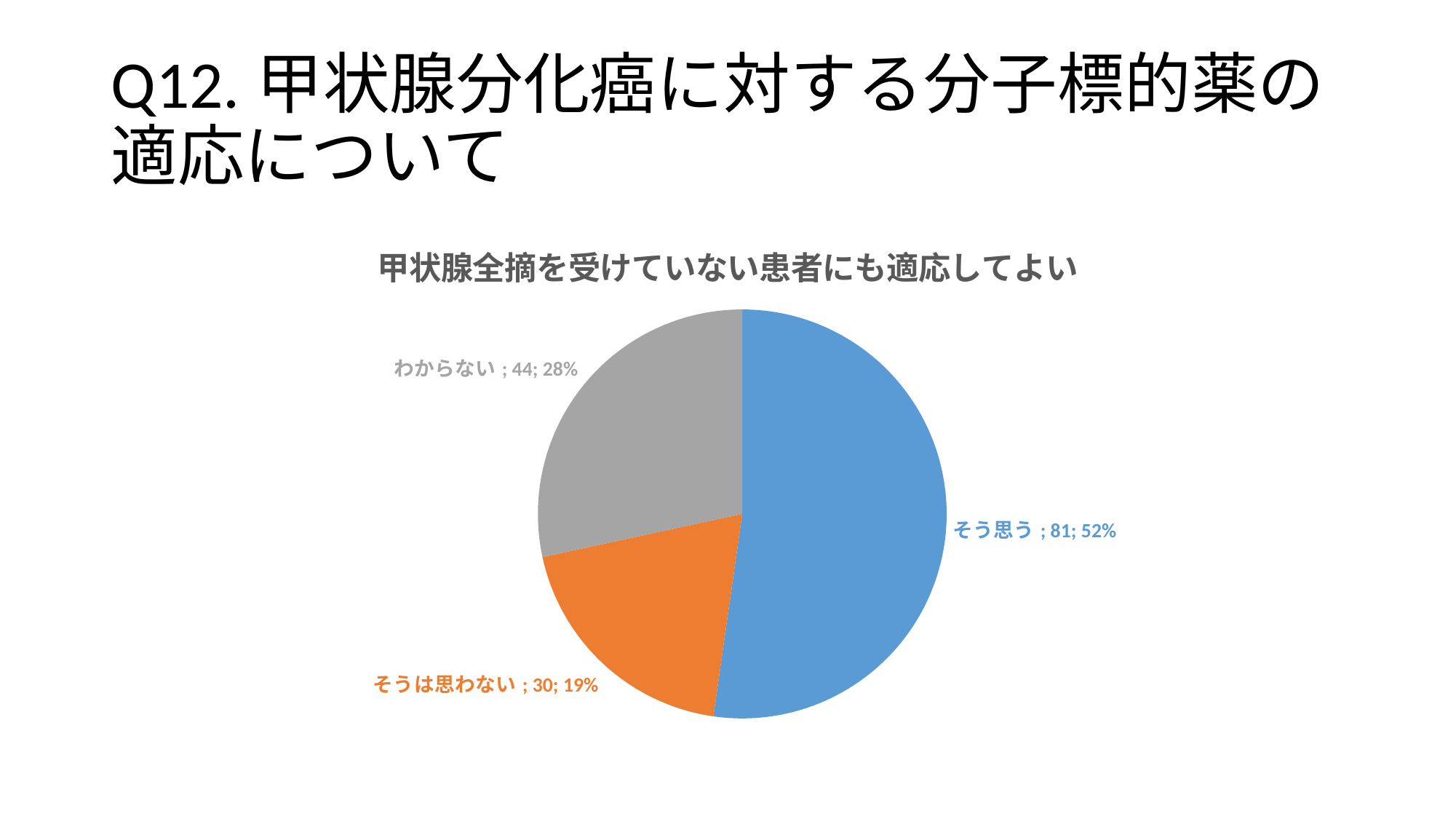
How many respondents answered そう思う? 81 What type of chart is shown on the slide? pie chart How many respondents answered わからない? 44 What is the difference in count between そう思う and わからない? 37 How many slices does the pie chart have? 3 Which category has the smallest slice? そうは思わない What share of the pie does そう思う represent? 52% What percentage of the pie is そうは思わない? 19% Which category has the largest slice? そう思う What is the title of the chart? 甲状腺全摘を受けていない患者にも適応してよい Which is larger, わからない or そうは思わない? わからない What colour is the そう思う slice? blue